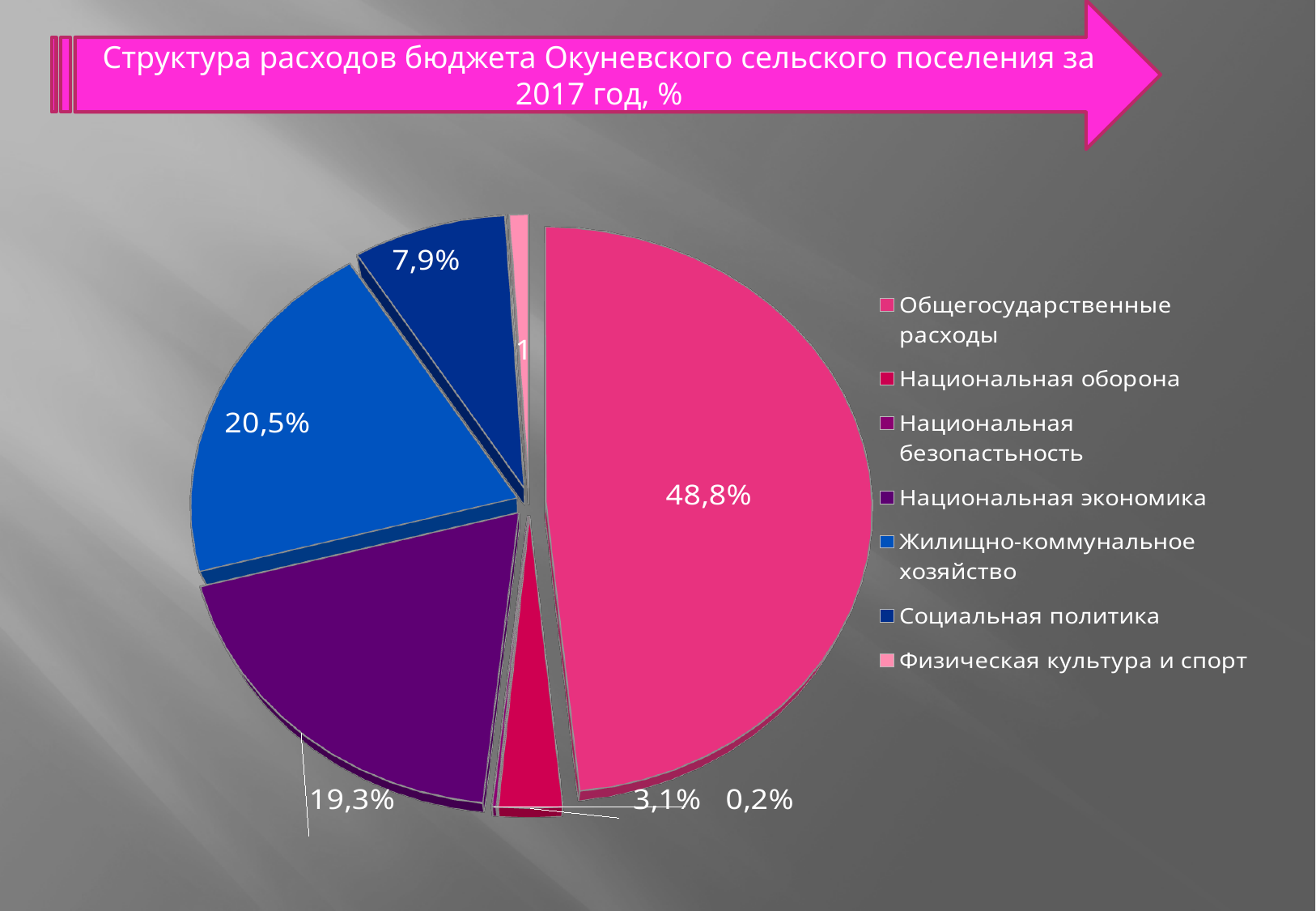
What kind of chart is shown on the slide? pie chart What is the value shown for Социальная политика? 7,9% By how many percentage points does Общегосударственные расходы exceed Жилищно-коммунальное хозяйство? 28,3 What is the value shown for Жилищно-коммунальное хозяйство? 20,5% What is the value shown for Национальная оборона? 3,1% What is the difference between Жилищно-коммунальное хозяйство and Национальная экономика in percentage points? 1,2 What share of the budget expenditure is Общегосударственные расходы? 48,8% What is the title of the chart on the slide? Структура расходов бюджета Окуневского сельского поселения за 2017 год, % Which is larger: Жилищно-коммунальное хозяйство or Национальная экономика? Жилищно-коммунальное хозяйство How many categories does the legend of the pie chart list? 7 What is the value shown for Национальная экономика? 19,3% Which category has the largest share of the pie? Общегосударственные расходы